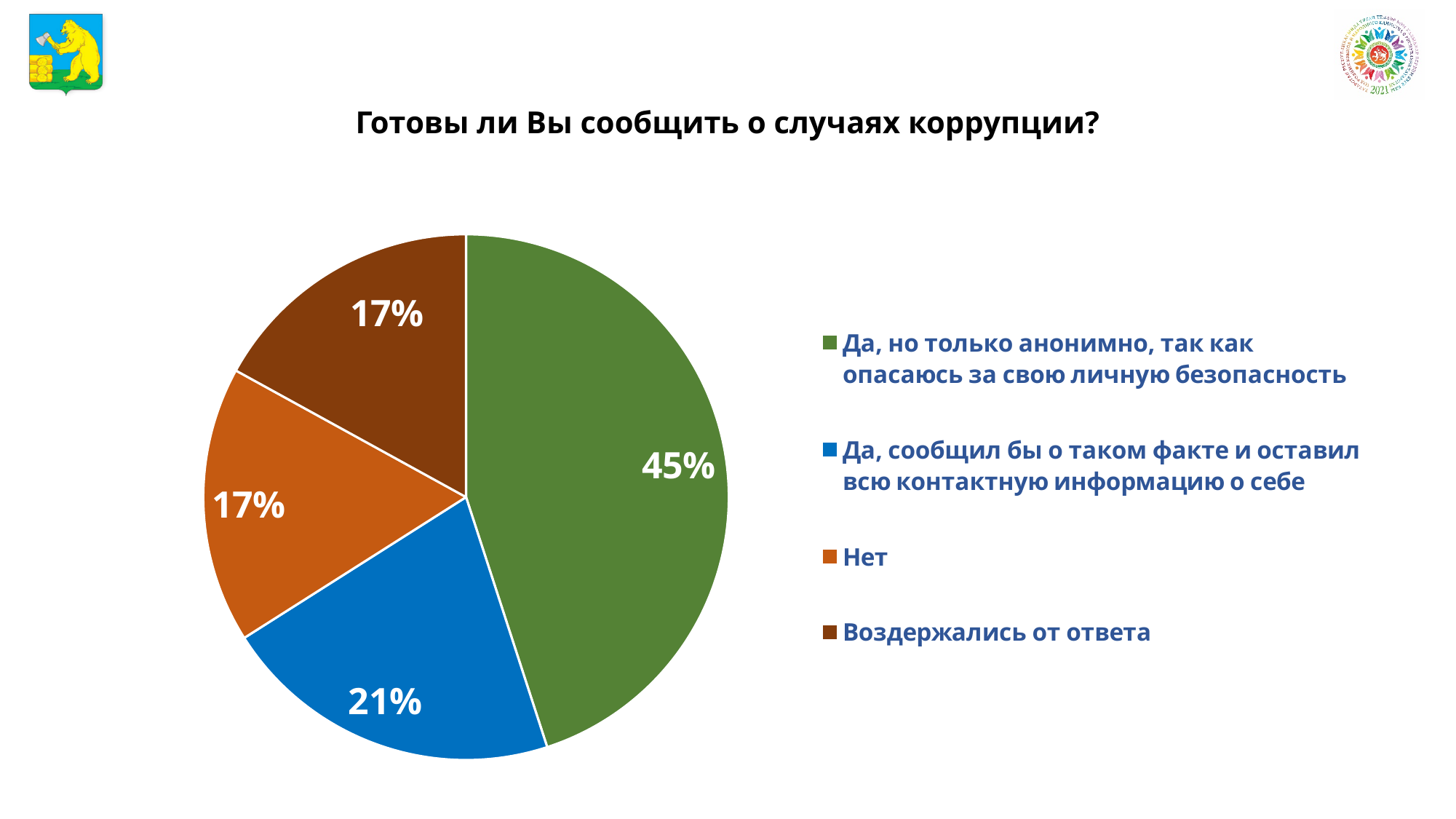
What percentage of respondents answered "Да, но только анонимно, так как опасаюсь за свою личную безопасность"? 45% What percentage of respondents answered "Нет"? 17% What colour is the slice for "Нет"? Orange Which is larger: the share for "Нет" or the share for "Да, сообщил бы о таком факте и оставил всю контактную информацию о себе"? Да, сообщил бы о таком факте и оставил всю контактную информацию о себе What kind of chart is shown on the slide? Pie chart What percentage of respondents answered "Да, сообщил бы о таком факте и оставил всю контактную информацию о себе"? 21% What percentage of respondents chose "Воздержались от ответа"? 17% How many categories does the legend list? 4 What is the difference in percentage points between "Да, но только анонимно..." and "Да, сообщил бы о таком факте..."? 24 percentage points What is the combined share of the two "Да" answers? 66% Which answer option has the largest share of the pie? Да, но только анонимно, так как опасаюсь за свою личную безопасность What is the title of the chart? Готовы ли Вы сообщить о случаях коррупции?